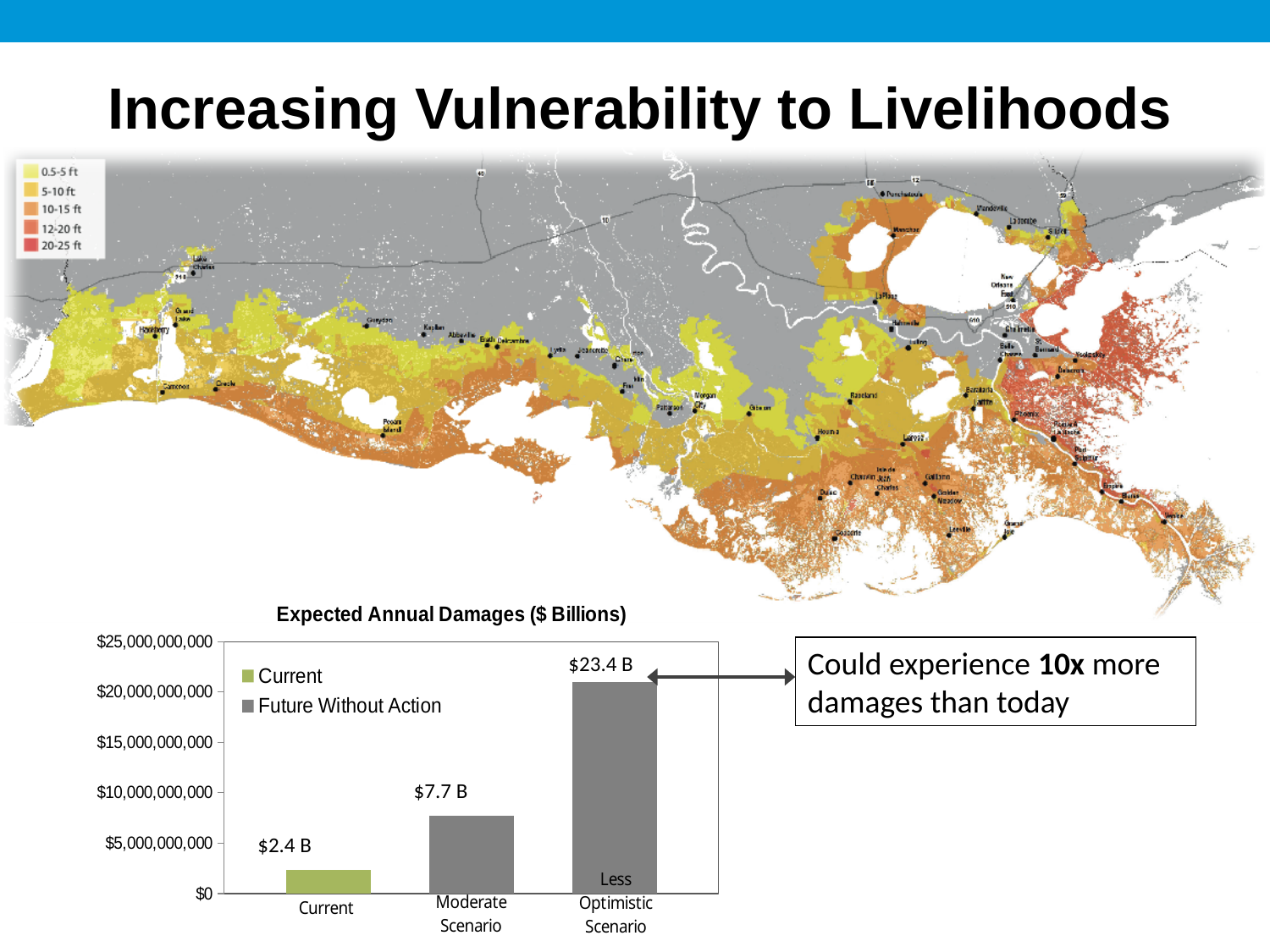
What is the expected annual damage value for the Current category? $2.4 B How many categories are shown on the x axis of the chart? 3 What is the expected annual damage value for the Less Optimistic Scenario? $23.4 B What is the expected annual damage value for the Moderate Scenario? $7.7 B How many series does the chart legend list? 2 What type of chart is shown at the bottom of the slide? Bar chart What is the difference between the Moderate Scenario and the Current value? $5.4 B Is the value for the Less Optimistic Scenario greater or less than $20,000,000,000? greater Which is larger, the Moderate Scenario value or the Current value? Moderate Scenario What is the difference between the Less Optimistic Scenario and the Current value? $21.0 B Which category has the highest expected annual damages? Less Optimistic Scenario Which category has the lowest expected annual damages? Current